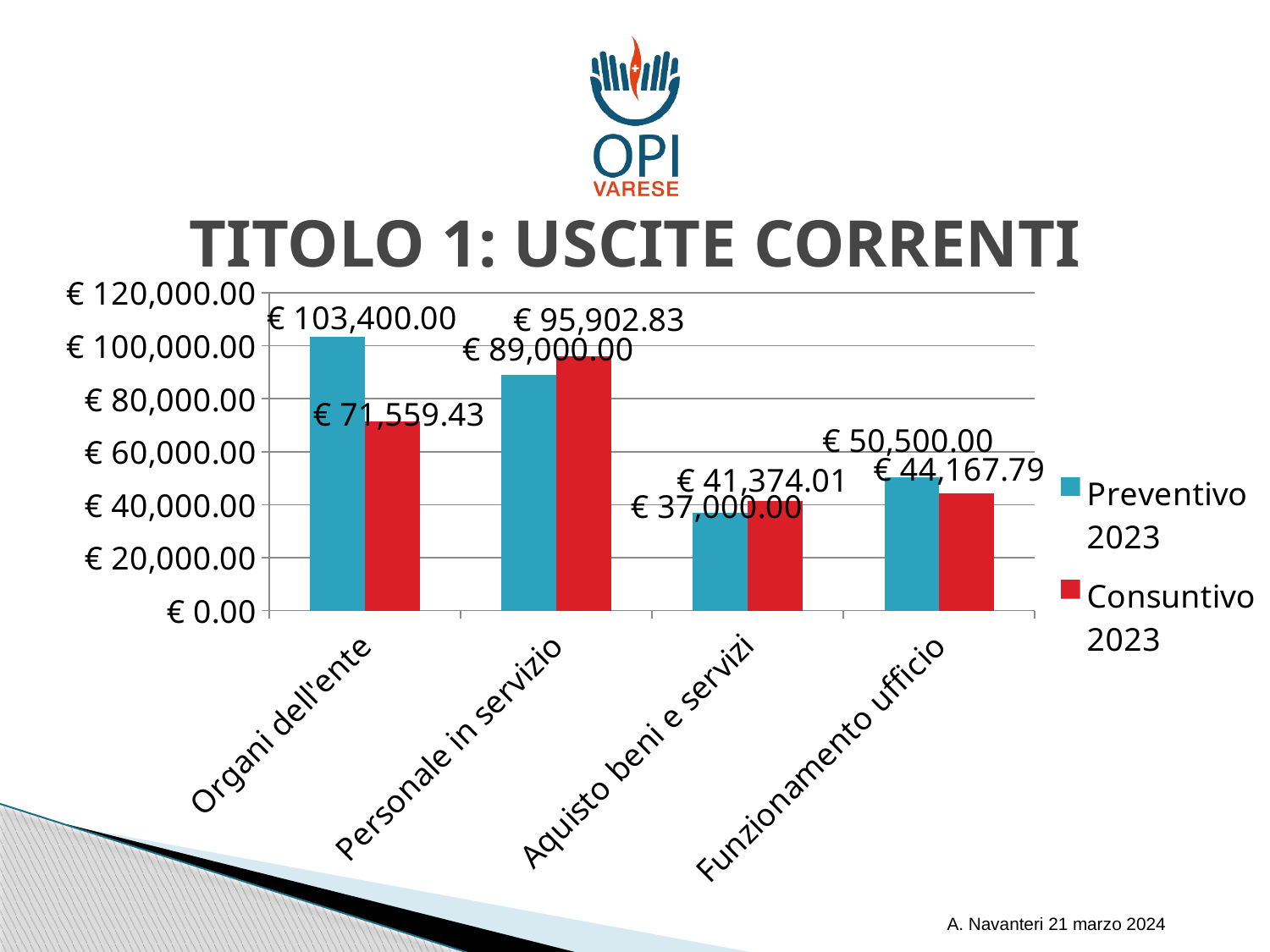
What is the Preventivo 2023 value for Funzionamento ufficio? € 50,500.00 For Personale in servizio, which is larger: Preventivo 2023 or Consuntivo 2023? Consuntivo 2023 What is the title of the chart? TITOLO 1: USCITE CORRENTI What type of chart is shown on the slide? Bar chart How many series does the legend list? 2 What is the Consuntivo 2023 value for Aquisto beni e servizi? € 41,374.01 Which category has the lowest Consuntivo 2023 value? Aquisto beni e servizi What is the Preventivo 2023 value for Organi dell'ente? € 103,400.00 Which category has the highest Preventivo 2023 value? Organi dell'ente What is the difference between the Preventivo 2023 and Consuntivo 2023 values for Organi dell'ente? € 31,840.57 How many categories are shown on the x axis? 4 What is the Consuntivo 2023 value for Personale in servizio? € 95,902.83